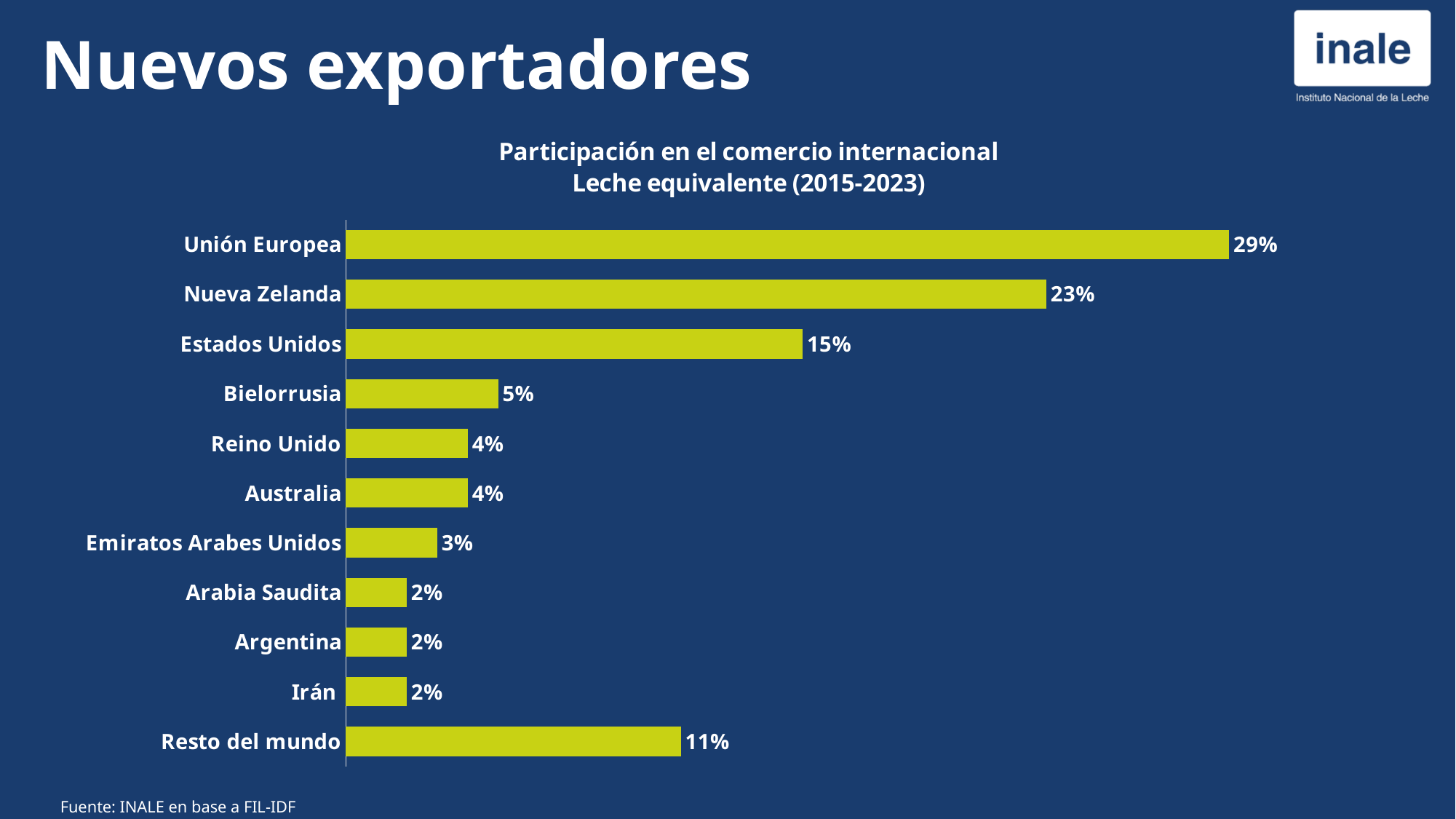
What is the value for Resto del mundo? 11% Which is larger, the value for Nueva Zelanda or the value for Estados Unidos? Nueva Zelanda What is the value for Unión Europea? 29% What is the value for Emiratos Arabes Unidos? 3% What is the difference between the values for Estados Unidos and Bielorrusia? 10% What is the title of the chart? Participación en el comercio internacional Leche equivalente (2015-2023) What is the difference between the values for Unión Europea and Nueva Zelanda? 6% Which is larger, the value for Resto del mundo or the value for Bielorrusia? Resto del mundo What kind of chart is shown on the slide? Bar chart How many categories are shown in the chart? 11 What is the value for Estados Unidos? 15% Which category has the highest value? Unión Europea